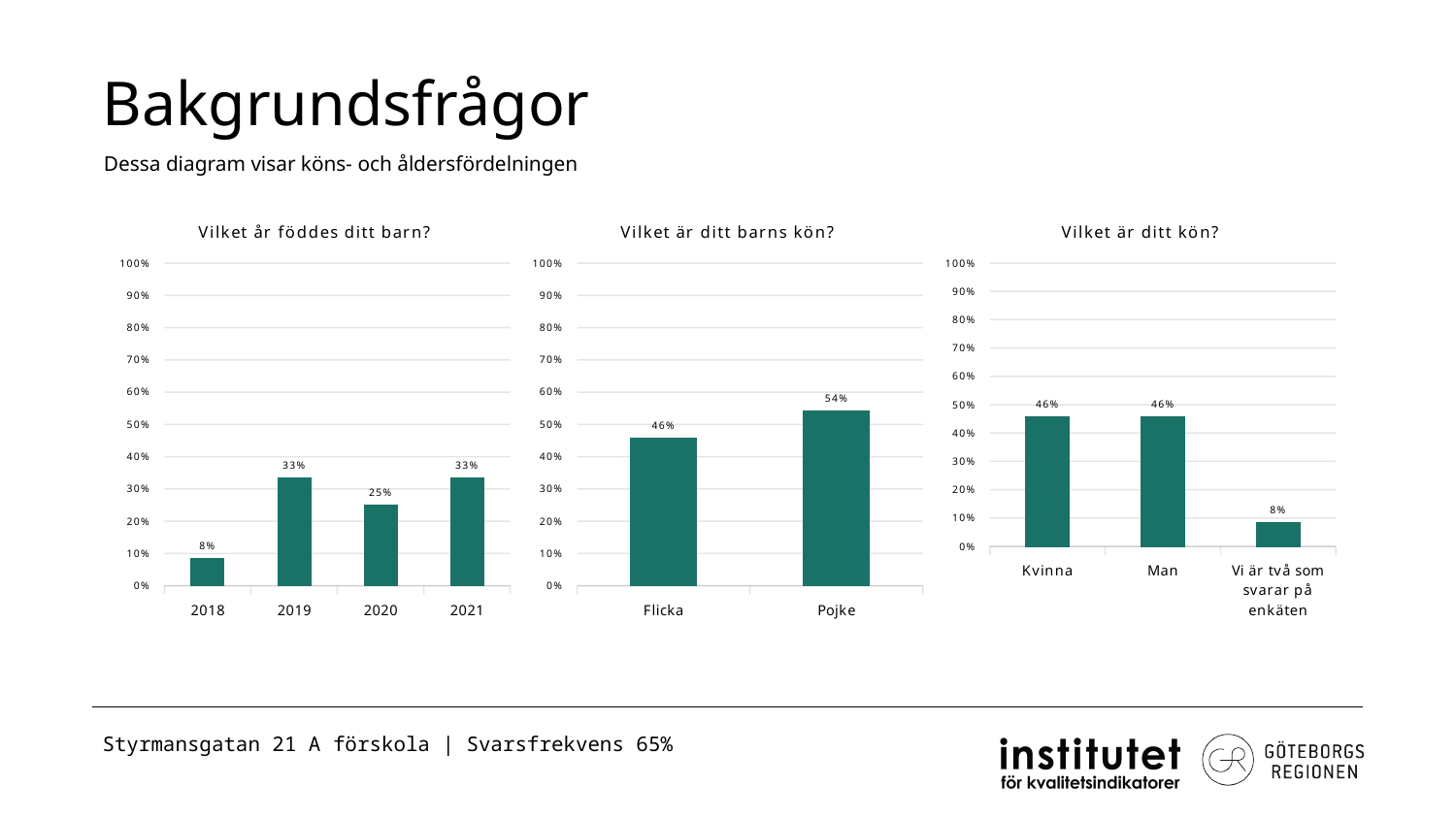
In the chart 'Vilket är ditt kön?', what is the value for 'Vi är två som svarar på enkäten'? 8% In the chart 'Vilket är ditt kön?', what is the value for Kvinna? 46% In the chart 'Vilket år föddes ditt barn?', what is the difference between the values for 2019 and 2018? 25% In the chart 'Vilket är ditt barns kön?', what is the value for Pojke? 54% In the chart 'Vilket år föddes ditt barn?', which year has the lowest value? 2018 In the chart 'Vilket är ditt barns kön?', which category has the higher value, Flicka or Pojke? Pojke What kind of chart is 'Vilket är ditt kön?'? Bar chart In the chart 'Vilket är ditt kön?', how many categories are shown on the x axis? 3 In the chart 'Vilket är ditt barns kön?', what is the difference between the values for Pojke and Flicka? 8% In the chart 'Vilket år föddes ditt barn?', how many categories are shown on the x axis? 4 How many charts are shown on the slide? 3 In the chart 'Vilket år föddes ditt barn?', what is the value for 2020? 25%